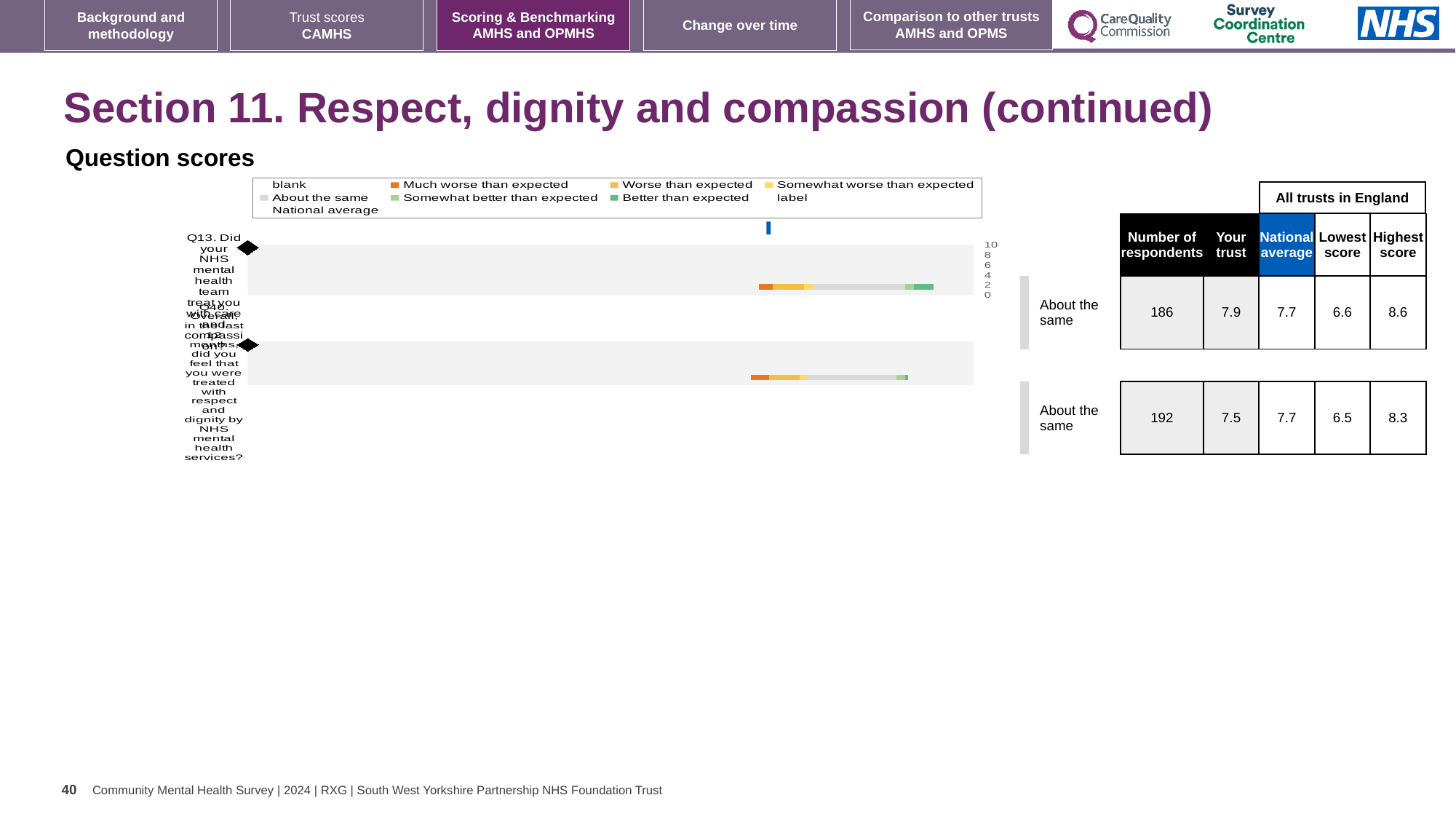
What kind of chart is shown under 'Question scores'? bar chart In the table beside the chart, what is the highest score for Q13? 8.6 Which question has the higher 'Your trust' score, Q13 or Q10? Q13 In the table beside the chart, what is the national average for Q13? 7.7 How many entries does the chart's legend list? 9 What is the highest tick value shown on the chart's axis? 10 In the table beside the chart, what is the number of respondents for Q13? 186 In the table beside the chart, what is the 'Your trust' score for Q10? 7.5 What is the difference between the 'Your trust' scores for Q13 and Q10? 0.4 What is the difference between the highest score and the lowest score for Q10? 1.8 What benchmark category label is shown next to both Q13 and Q10? About the same How many questions (categories) are plotted on the chart? 2